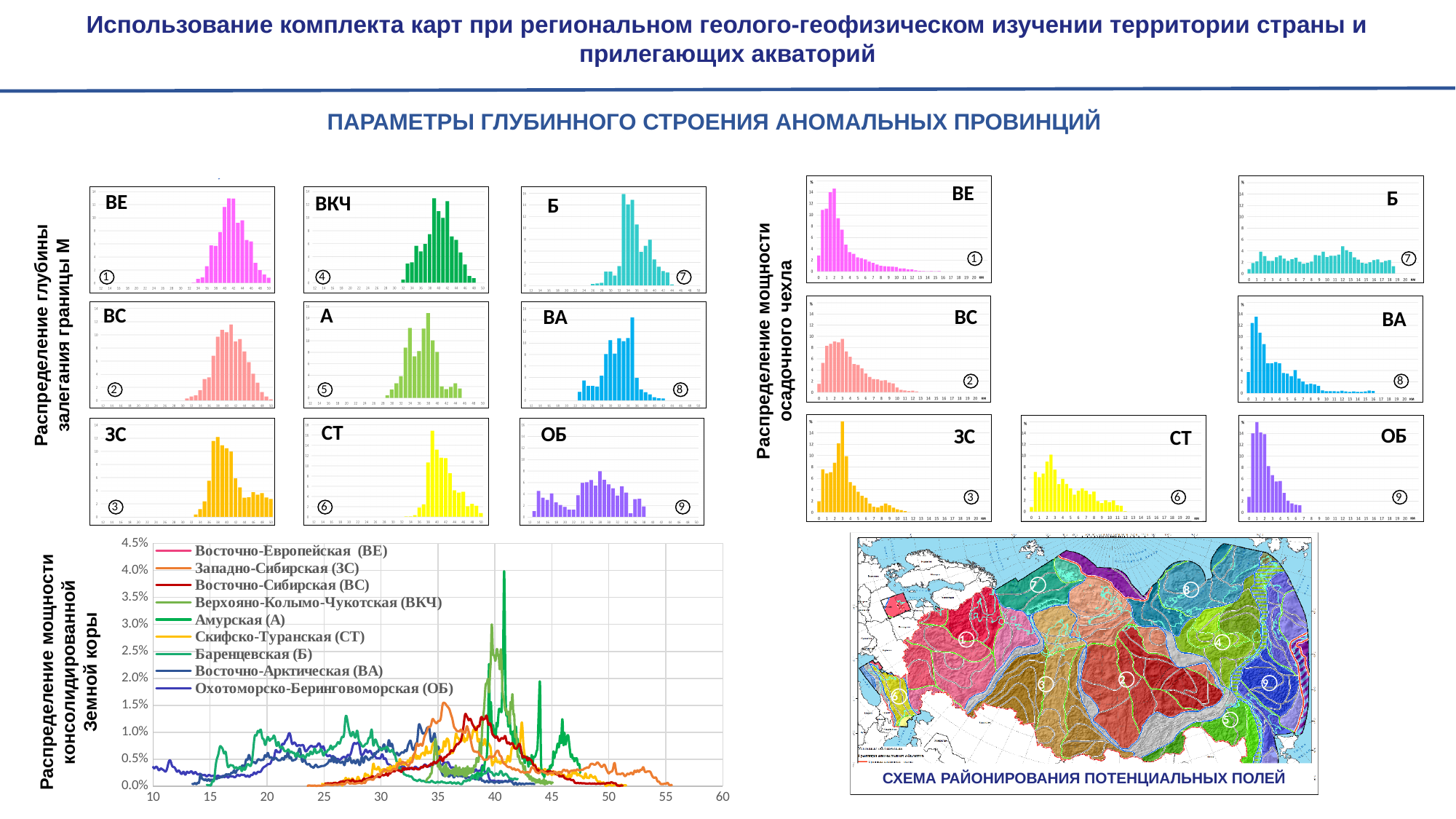
In the bottom-left line chart, is the peak value of the Амурская (А) series greater or less than 3.5%? greater What range does the x axis of the bottom-left line chart cover? 10 to 60 In the bottom-left line chart, which series reaches the highest peak? Амурская (А) How many series does the legend of the bottom-left line chart list? 9 In the bottom-left line chart, which series has the higher peak: Амурская (А) or Восточно-Европейская (ВЕ)? Амурская (А) In the bottom-left line chart, is the peak value of the Западно-Сибирская (ЗС) series greater or less than 1.0%? greater What kind of chart is each of the small panels labelled ВЕ, ВКЧ, Б, ВС, А, ВА, ЗС, СТ and ОБ? bar chart What is the highest value shown on the y axis of the bottom-left line chart? 4.5% What kind of chart is the large chart at the bottom left of the slide (Распределение мощности консолидированной Земной коры)? line chart In the bottom-left line chart, is the peak value of the Восточно-Сибирская (ВС) series greater or less than 2.0%? less How many small histogram panels are in the group labelled 'Распределение мощности осадочного чехла' on the right of the slide? 7 How many small histogram panels are in the group labelled 'Распределение глубины залегания границы М' on the left of the slide? 9